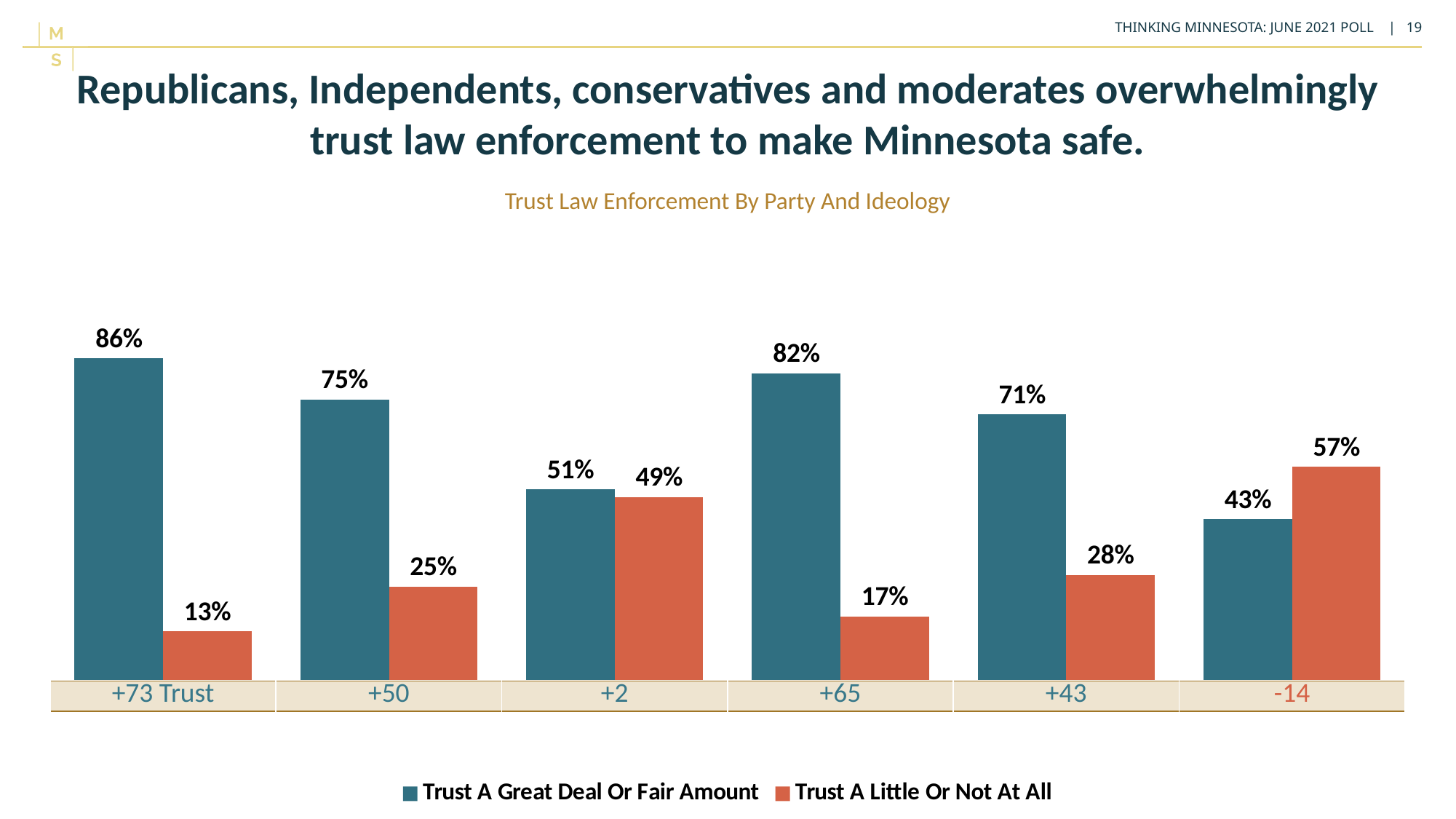
How many groups of bars are plotted in the chart? 6 What is the 'Trust A Great Deal Or Fair Amount' value for the group labelled '+73 Trust'? 86% What kind of chart is shown on the slide? Bar chart Which group has the lowest 'Trust A Little Or Not At All' value? +73 Trust How many series does the legend list? 2 In the group labelled '-14', which series has the larger value? Trust A Little Or Not At All What is the 'Trust A Great Deal Or Fair Amount' value for the group labelled '+65'? 82% What is the subtitle of the chart? Trust Law Enforcement By Party And Ideology What is the 'Trust A Little Or Not At All' value for the group labelled '-14'? 57% In the group labelled '+50', what is the difference between the 'Trust A Great Deal Or Fair Amount' and 'Trust A Little Or Not At All' values? 50 percentage points What is the sum of the two values in the group labelled '+2'? 100% Which group has the highest 'Trust A Great Deal Or Fair Amount' value? +73 Trust